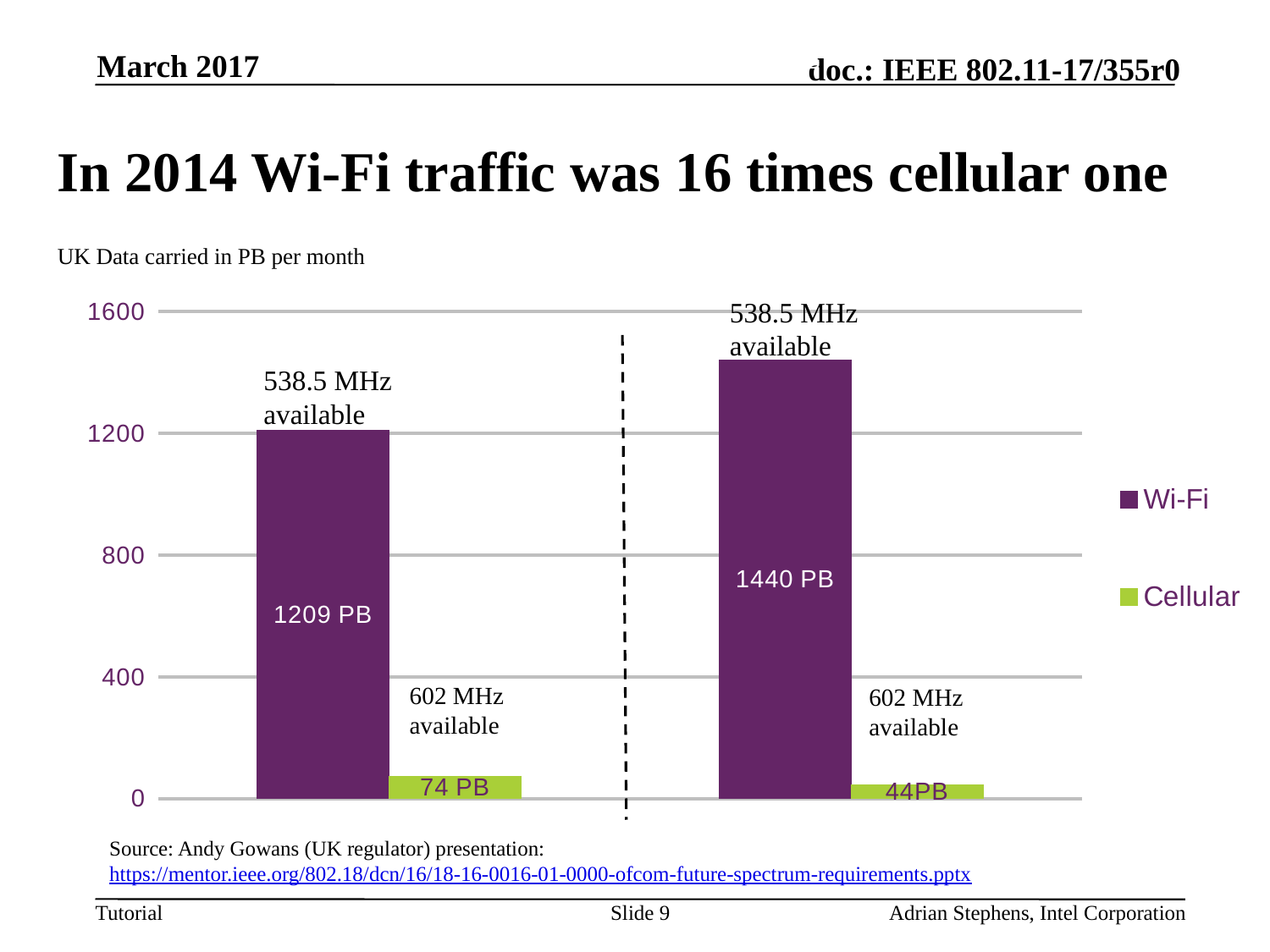
What are the two series named in the legend? Wi-Fi and Cellular How many series does the legend list? 2 Which bar has the lowest value on the chart? Cellular in the right group (44PB) What kind of chart is shown on the slide? bar chart What is the Wi-Fi value in the right group of bars? 1440 PB What is the Wi-Fi value in the left group of bars? 1209 PB What is the difference between the Wi-Fi values of the right group and the left group? 231 PB What is the Cellular value in the right group of bars? 44PB What is the Cellular value in the left group of bars? 74 PB Which bar has the highest value on the chart? Wi-Fi in the right group (1440 PB) Is the Wi-Fi value in the left group greater or less than 1200? greater Which is larger, the Cellular value in the left group or the Cellular value in the right group? the left group (74 PB)